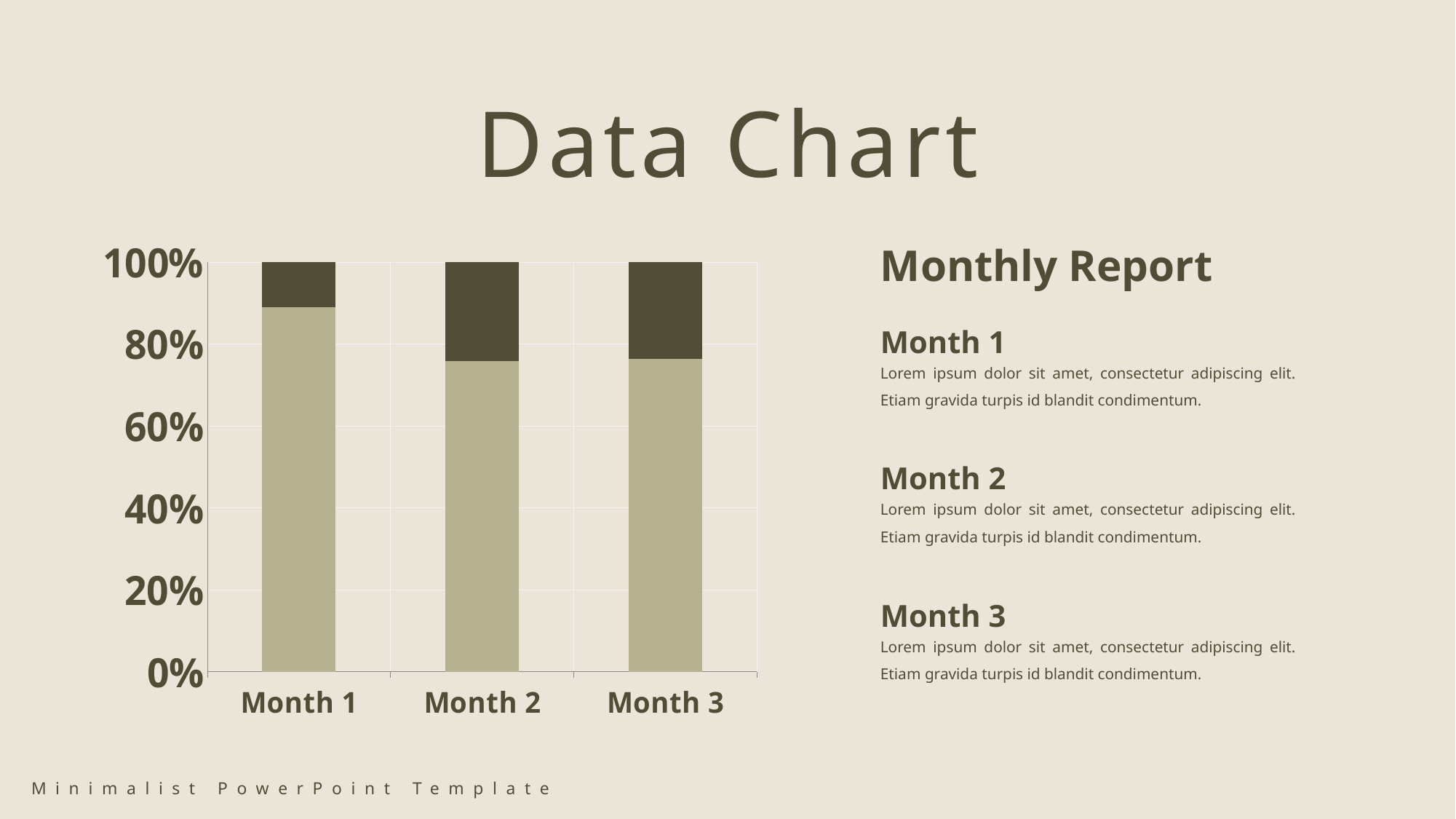
Is the lighter (bottom) segment for Month 2 greater or less than 80%? less Is the lighter (bottom) segment for Month 3 greater or less than 80%? less Which month has the smallest darker (top) segment? Month 1 Is the lighter (bottom) segment larger for Month 1 or Month 2? Month 1 How many segments does each stacked bar in the chart have? 2 What is the total height of the stacked bar for Month 3? 100% Is the lighter (bottom) segment for Month 1 greater or less than 80%? greater What kind of chart is shown on the slide? stacked bar chart How many categories are shown on the x axis of the chart? 3 Which month has the largest lighter (bottom) segment? Month 1 What is the highest value labelled on the y axis of the chart? 100% What is the total height of the stacked bar for Month 1? 100%